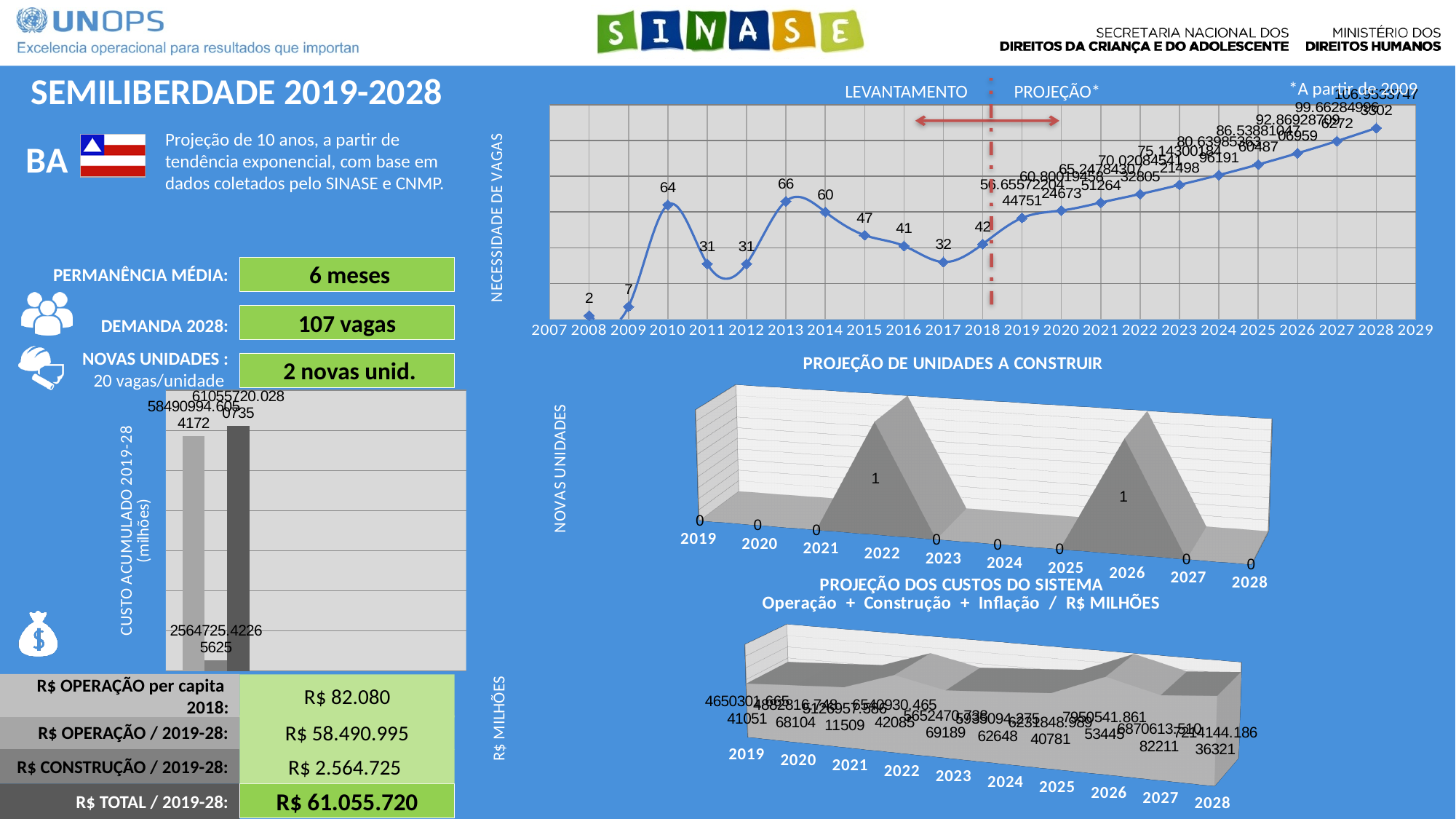
In the chart PROJEÇÃO DE UNIDADES A CONSTRUIR, what is the value for 2022? 1 In the top line chart (NECESSIDADE DE VAGAS), what is the value for 2010? 64 In the top line chart (NECESSIDADE DE VAGAS), do the values rise or fall across the PROJEÇÃO period from 2019 to 2028? rise In the chart PROJEÇÃO DE UNIDADES A CONSTRUIR, how many years are shown on the x axis? 10 In the top line chart (NECESSIDADE DE VAGAS), what is the difference between the 2013 value and the 2010 value? 2 In the top line chart (NECESSIDADE DE VAGAS), what is the value for 2013? 66 In the top line chart (NECESSIDADE DE VAGAS), which year in the LEVANTAMENTO period (2008-2018) has the highest value? 2013 In the top line chart (NECESSIDADE DE VAGAS), which year in the LEVANTAMENTO period (2008-2018) has the lowest value? 2008 In the top line chart (NECESSIDADE DE VAGAS), which year has the larger value, 2014 or 2015? 2014 What kind of chart is the top chart labelled NECESSIDADE DE VAGAS? line chart In the top line chart (NECESSIDADE DE VAGAS), what is the value for 2017? 32 What is the vertical axis label of the chart PROJEÇÃO DE UNIDADES A CONSTRUIR? NOVAS UNIDADES